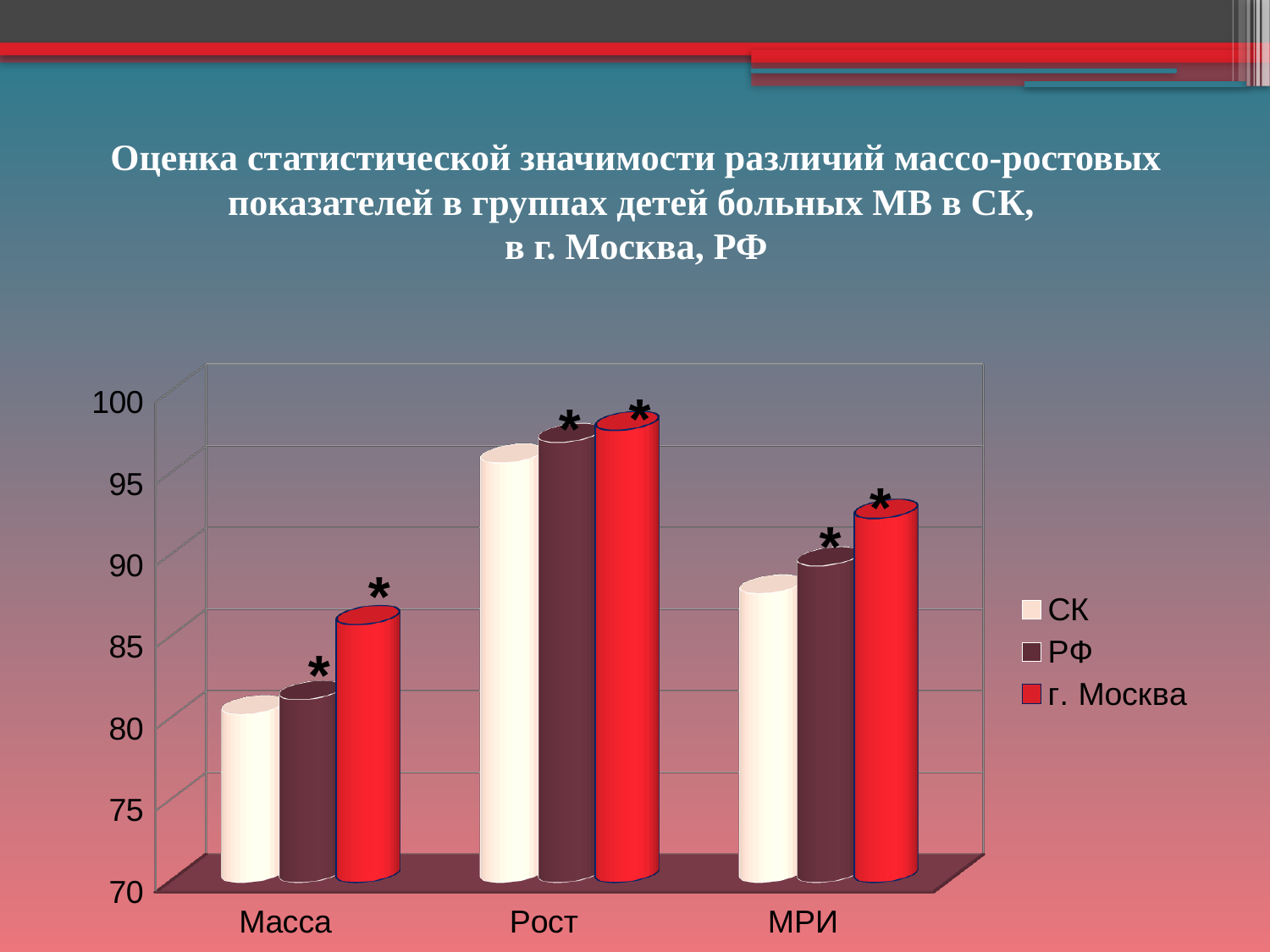
Is the value for СК in the МРИ category greater or less than 90? less Is the value for СК in the Рост category greater or less than 95? greater What kind of chart is shown on the slide? bar chart Is the value for г. Москва in the Масса category greater or less than 85? greater For the СК series, which category has the lowest value? Масса How many categories are shown on the x axis of the chart? 3 In the Масса category, which is larger: the value for СК or the value for г. Москва? г. Москва How many series does the chart legend list? 3 For the г. Москва series, which category has the highest value? Рост Which series are listed in the chart legend? СК, РФ, г. Москва